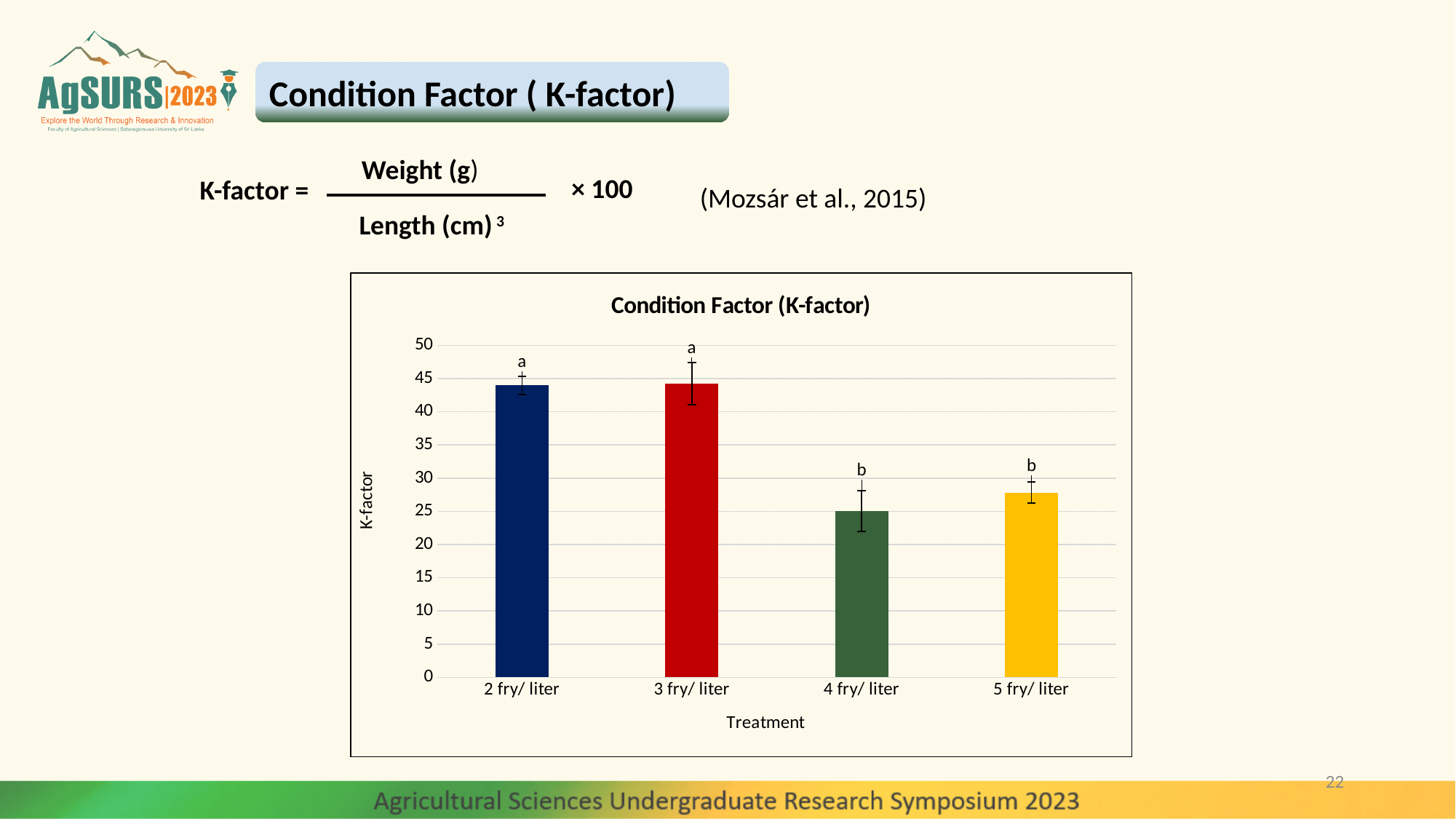
Is the K-factor for 4 fry/ liter greater or less than 30? less Is the K-factor for 4 fry/ liter greater or less than 20? greater Which has a higher K-factor, 2 fry/ liter or 4 fry/ liter? 2 fry/ liter How many treatment categories are plotted on the x axis? 4 Which treatment has the lowest K-factor? 4 fry/ liter Is the K-factor for 2 fry/ liter greater or less than 40? greater What is the label of the y axis? K-factor What kind of chart is shown on the slide? bar chart What is the title of the chart? Condition Factor (K-factor) Which has a higher K-factor, 5 fry/ liter or 3 fry/ liter? 3 fry/ liter